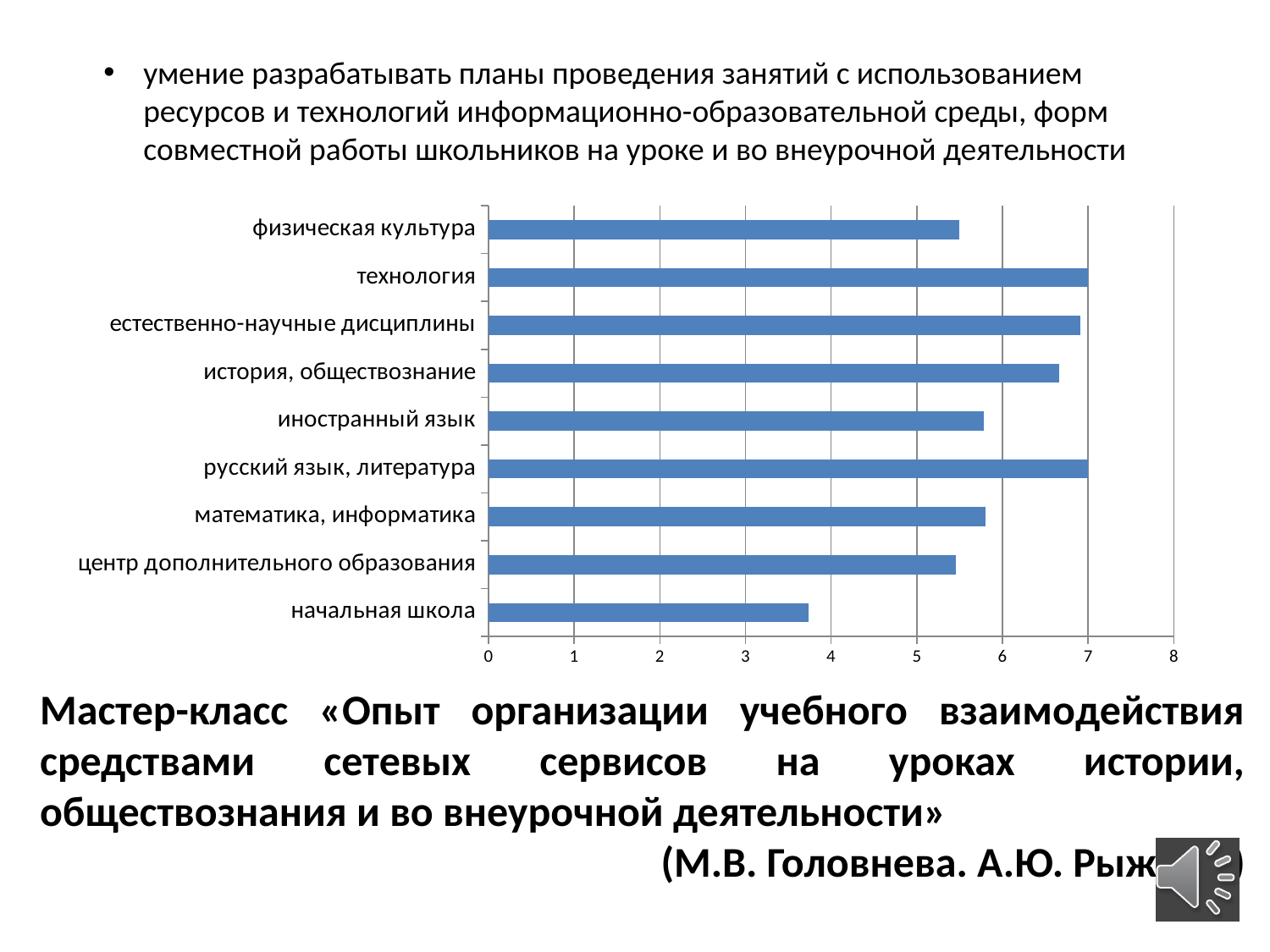
Which is larger, the value for математика, информатика or the value for русский язык, литература? русский язык, литература Is the value for естественно-научные дисциплины greater or less than 6? greater Which category has the lowest value on the chart? начальная школа Is the value for начальная школа greater or less than 4? less Is the value for физическая культура greater or less than 5? greater Which is larger, the value for история, обществознание or the value for начальная школа? история, обществознание How many categories are plotted on the chart? 9 Which is larger, the value for технология or the value for физическая культура? технология What kind of chart is shown on the slide? bar chart What colour are the bars on the chart? blue